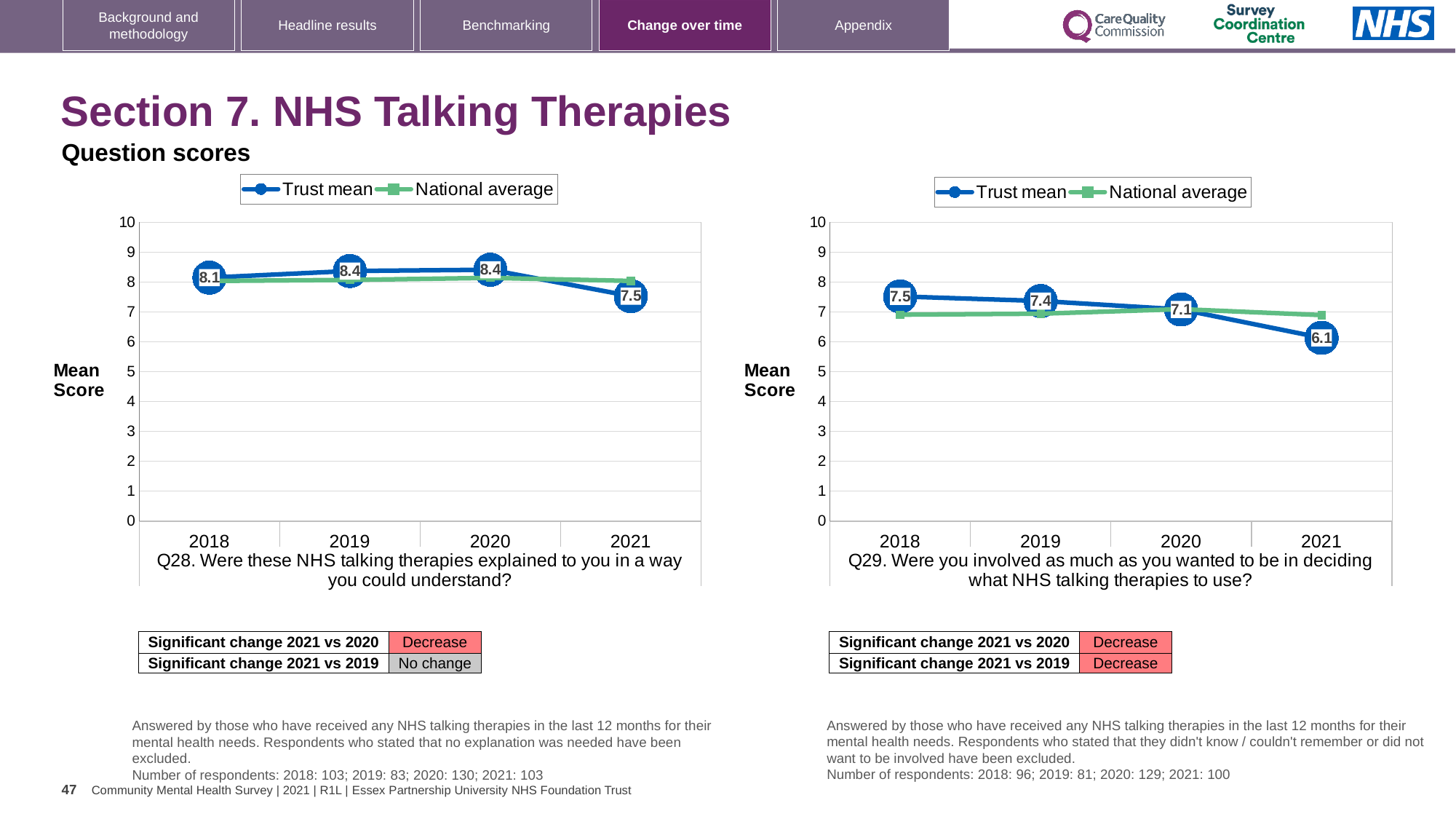
In the Q28 chart (left), which year has the lowest Trust mean? 2021 In the Q29 chart (right), what is the Trust mean for 2021? 6.1 In the Q28 chart (left), what is the Trust mean for 2021? 7.5 What kind of chart is the Q29 chart (right)? line chart In the Q28 chart (left), what is the difference between the Trust mean in 2020 and in 2021? 0.9 In the Q29 chart (right), does the Trust mean rise or fall from 2018 to 2021? fall In the Q29 chart (right), is the Trust mean for 2021 greater or less than 7? less How many series does the legend of the Q28 chart (left) list? 2 In the Q28 chart (left), what is the Trust mean for 2018? 8.1 In the Q29 chart (right), which year has the lowest Trust mean? 2021 In the Q29 chart (right), what is the Trust mean for 2019? 7.4 In the Q29 chart (right), what is the difference between the Trust mean in 2018 and in 2021? 1.4